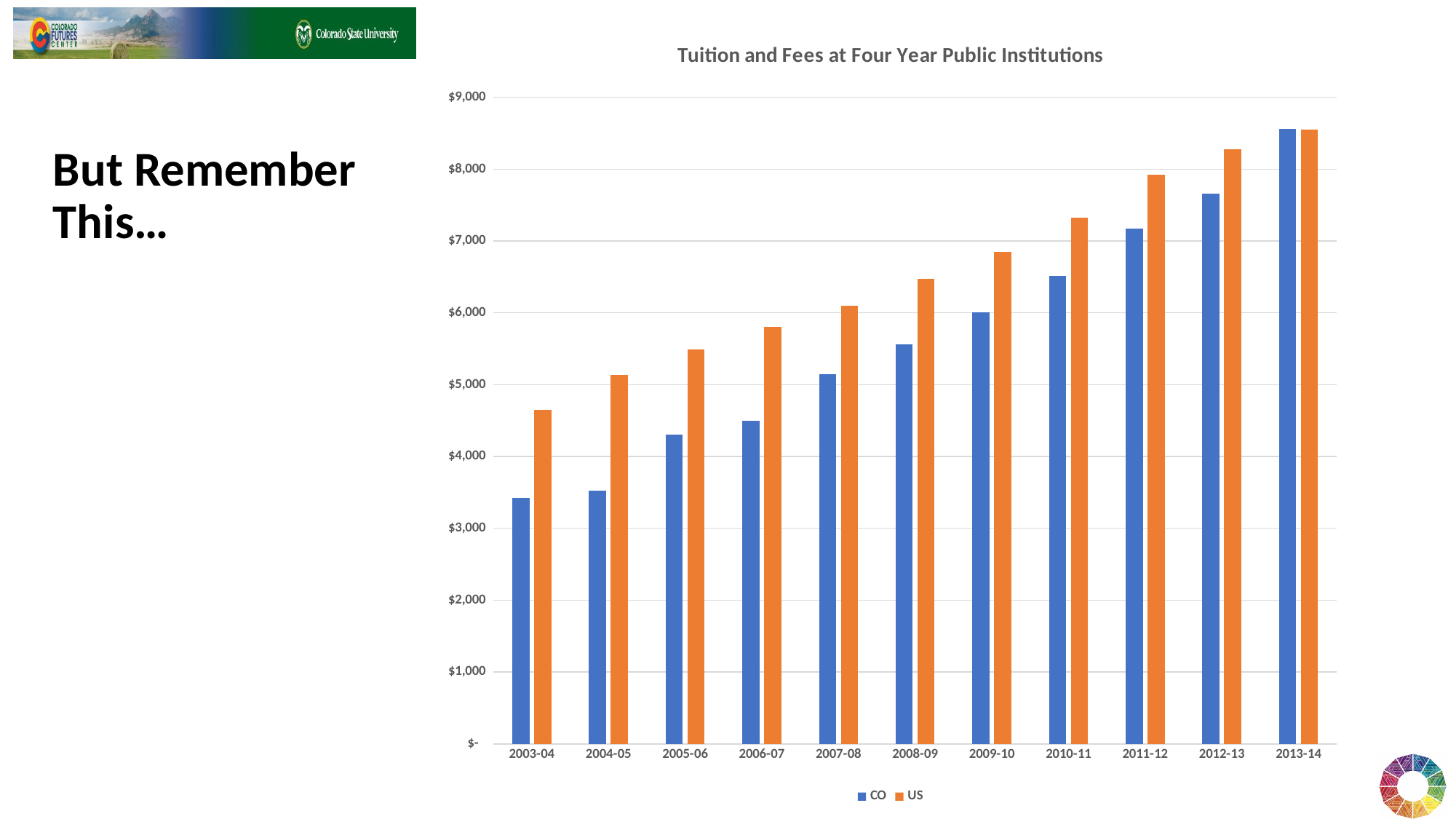
Is the CO value for 2011-12 greater or less than $7,000? greater Do the US values rise or fall from 2003-04 to 2013-14? rise Which colour represents the CO series? blue How many academic years are shown on the x axis? 11 How many series does the legend list? 2 In 2003-04, which is larger, the CO value or the US value? US Is the US value for 2012-13 greater or less than $8,000? greater What type of chart is shown on the slide? bar chart What is the title of the chart? Tuition and Fees at Four Year Public Institutions Which year has the lowest CO value? 2003-04 Is the CO value for 2003-04 greater or less than $4,000? less Which year has the highest US value? 2013-14